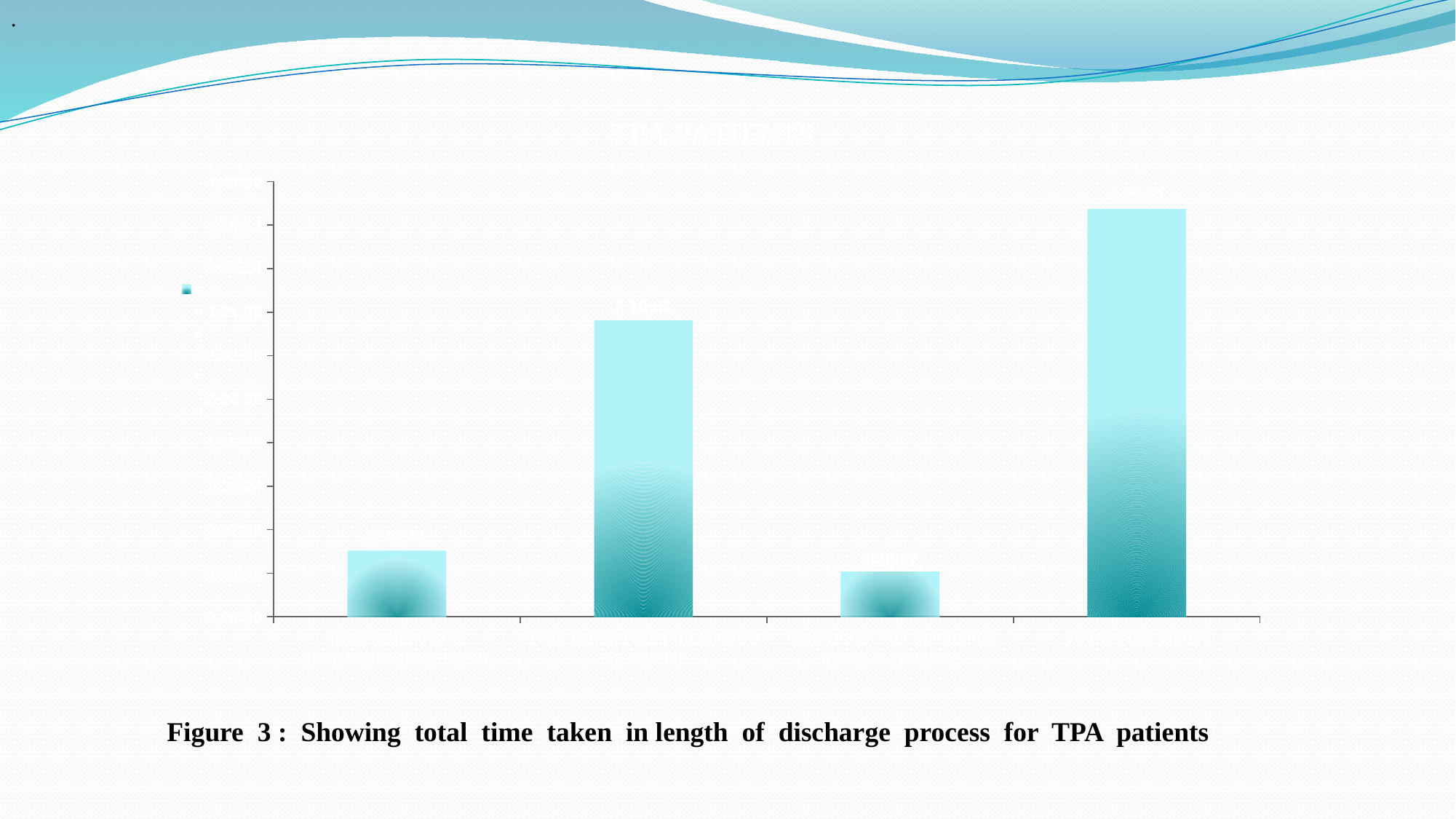
Which is taller in the chart, the second bar or the fourth bar from the left? the fourth bar Which bar in the chart is the shortest, counting from the left? the third bar What does the figure caption below the chart say the chart shows? Total time taken in length of discharge process for TPA patients Which is taller in the chart, the first bar or the third bar from the left? the first bar Do the bar heights rise steadily from left to right across the chart? No What kind of chart is shown on the slide? bar chart Which bar in the chart is the tallest, counting from the left? the fourth (rightmost) bar What is the title shown above the chart? TPA PATIENTS How many bars are plotted in the chart? 4 Which is taller in the chart, the first bar or the second bar from the left? the second bar